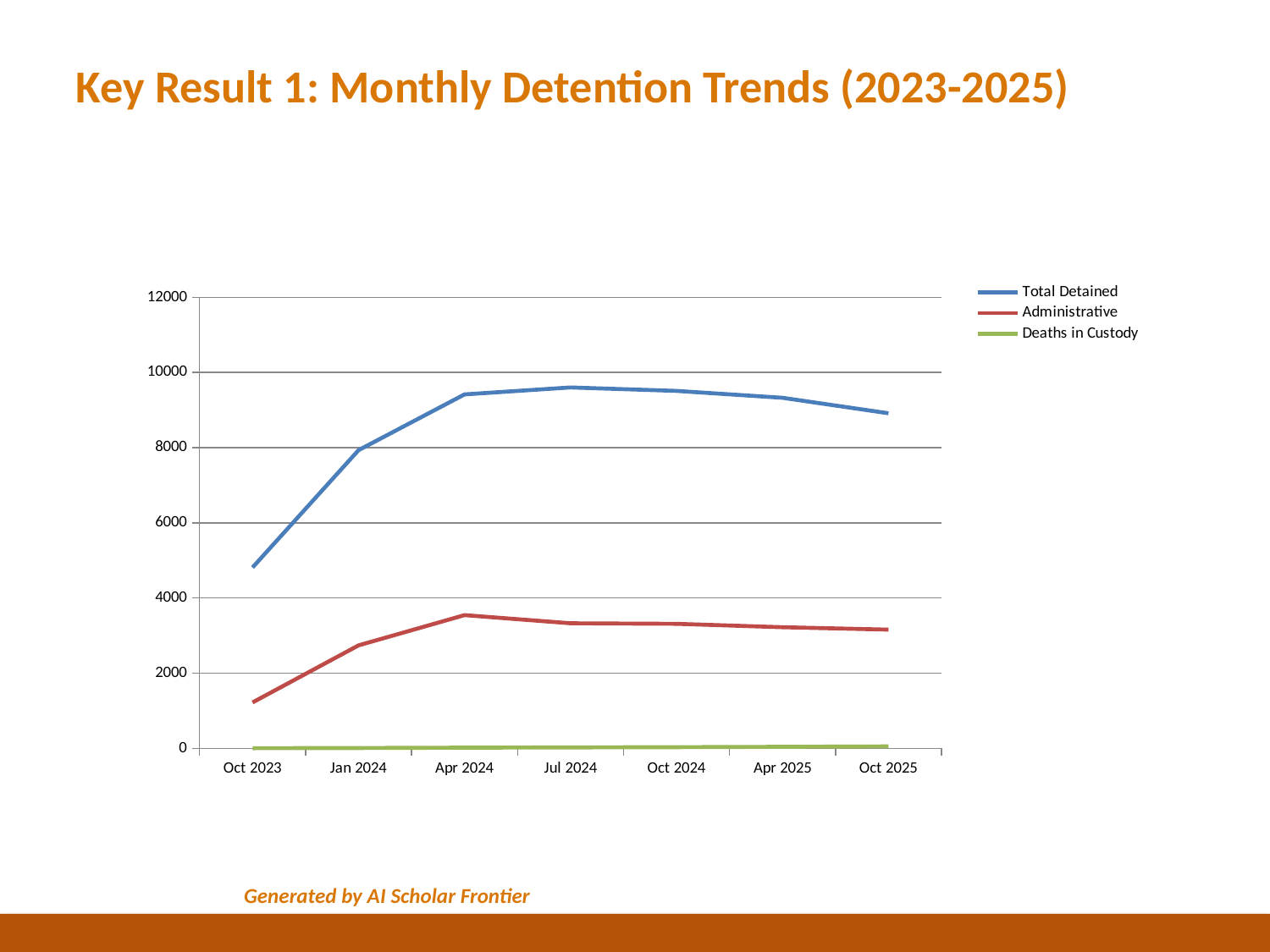
Is the value for Total Detained in Oct 2025 greater or less than 8000? greater Is the value for Total Detained in Apr 2024 greater or less than 10000? less What kind of chart is shown on the slide? line chart How many series does the legend list? 3 At which time point is the Total Detained series lowest? Oct 2023 Is the value for Total Detained in Oct 2023 greater or less than 6000? less Does the Total Detained series rise or fall from Jul 2024 to Oct 2025? fall At which time point is the Administrative series highest? Apr 2024 How many time points are shown on the x axis? 7 Which series has the larger value in Jul 2024, Total Detained or Administrative? Total Detained